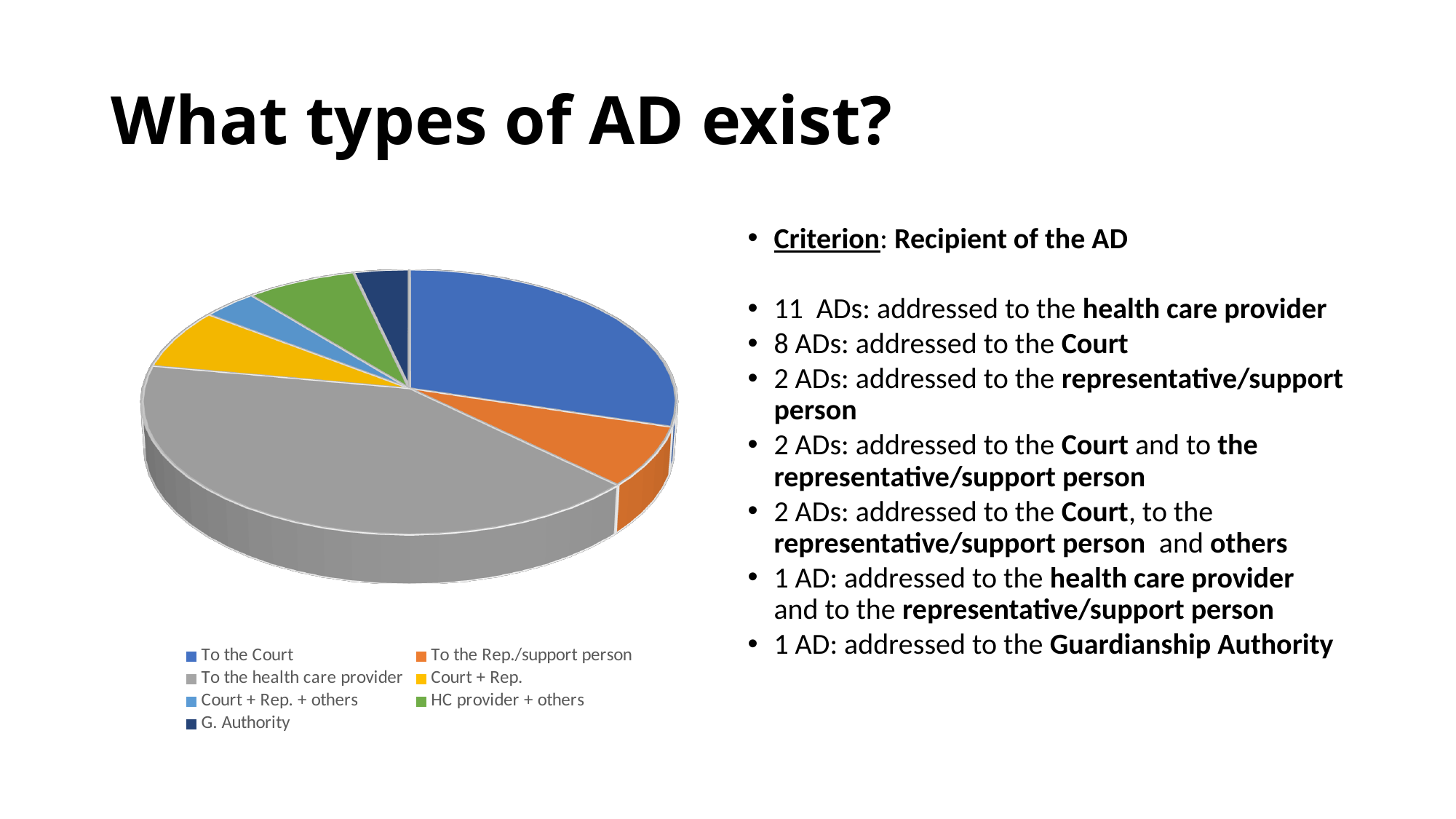
Which slice is larger: "To the Court" or "To the Rep./support person"? To the Court How many categories does the pie chart's legend list? 7 What kind of chart is shown on the slide? pie chart Which slice is larger: "HC provider + others" or "Court + Rep. + others"? HC provider + others Which slice is larger: "To the Court" or "G. Authority"? To the Court Which category has the largest slice of the pie chart? To the health care provider What colour is the "To the health care provider" slice in the pie chart? gray Which legend entry is shown in green? HC provider + others